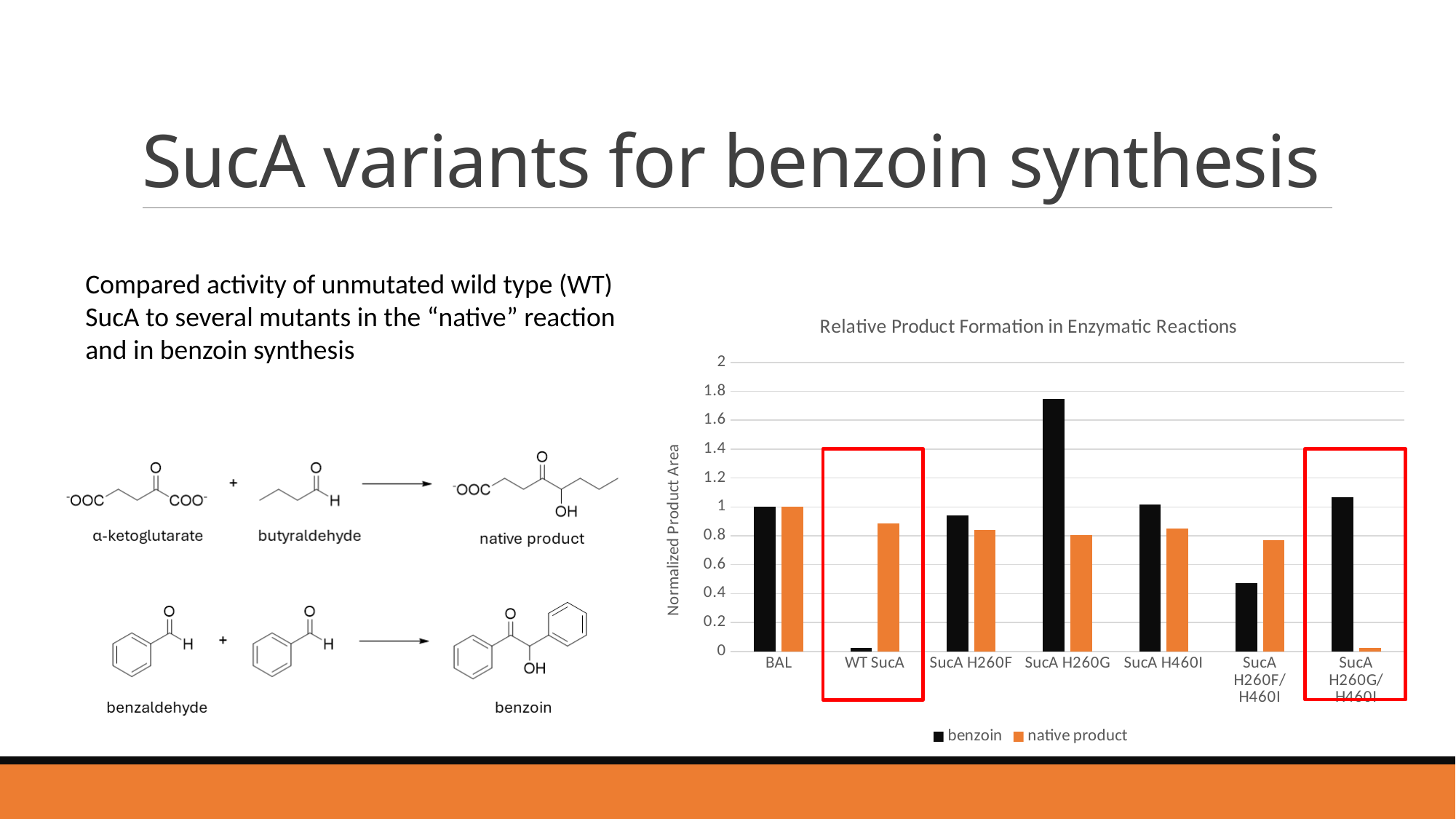
Is the benzoin value for SucA H260G greater or less than 1.4? greater How many series does the legend of the chart list? 2 What is the title of the y axis of the chart? Normalized Product Area Is the benzoin value for SucA H260F/H460I greater or less than 0.6? less How many enzyme categories are shown on the x axis of the chart? 7 What is the native product value for BAL? 1 For WT SucA, which is larger: the benzoin value or the native product value? native product Which category has the lowest native product value? SucA H260G/H460I What type of chart is shown on the slide? bar chart What is the benzoin value for BAL? 1 Which category has the lowest benzoin value? WT SucA Which category has the highest benzoin value? SucA H260G